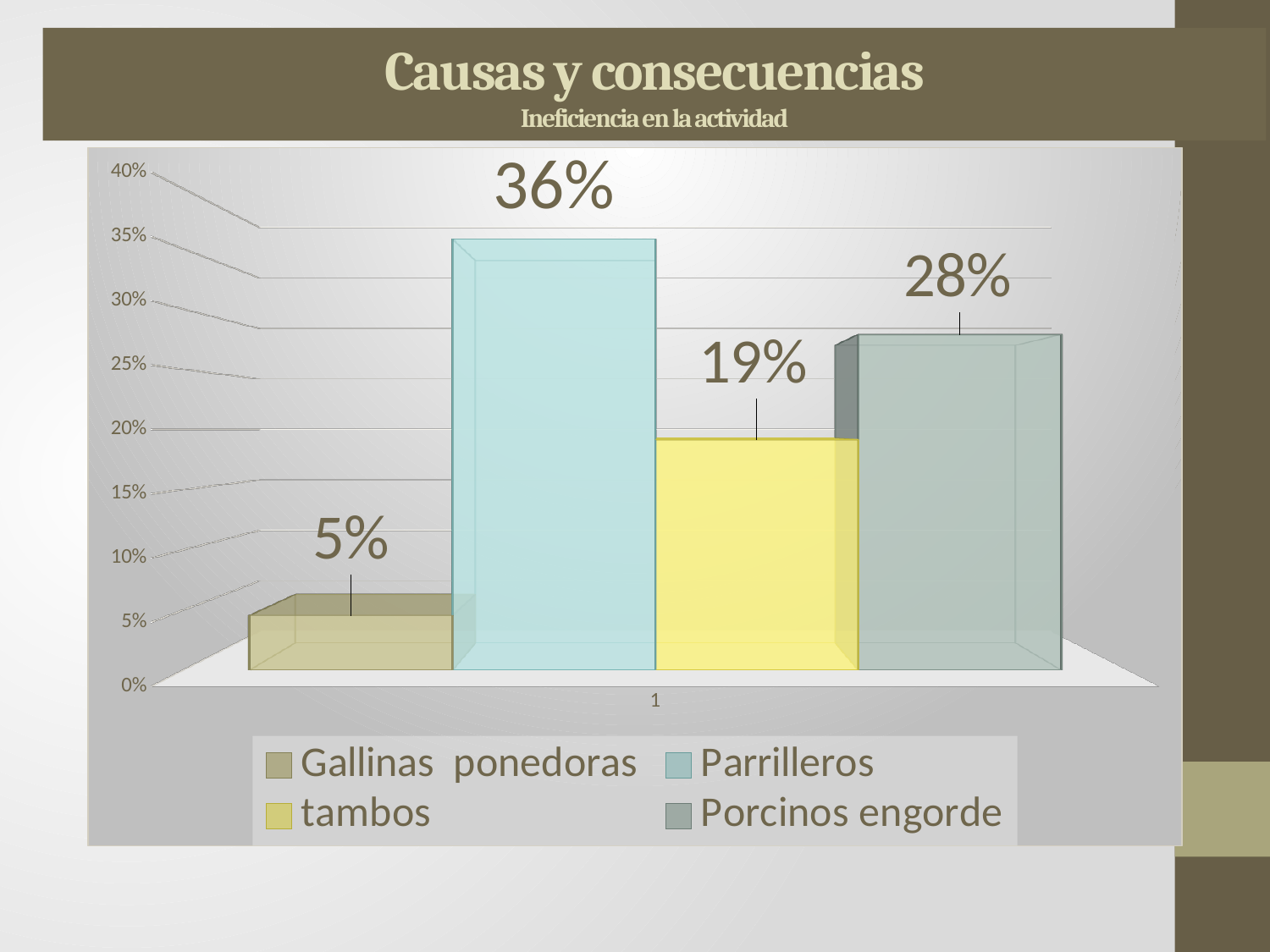
What is the value for Gallinas ponedoras? 5% What colour is the bar for tambos? Yellow What is the value for Parrilleros? 36% What is the difference between the values for Parrilleros and Porcinos engorde? 8% Which is larger, the value for tambos or the value for Porcinos engorde? Porcinos engorde What is the difference between the values for tambos and Gallinas ponedoras? 14% What is the value for tambos? 19% What kind of chart is shown on the slide? Bar chart Which series has the lowest value? Gallinas ponedoras Which series has the highest value? Parrilleros How many series does the legend list? 4 What is the value for Porcinos engorde? 28%